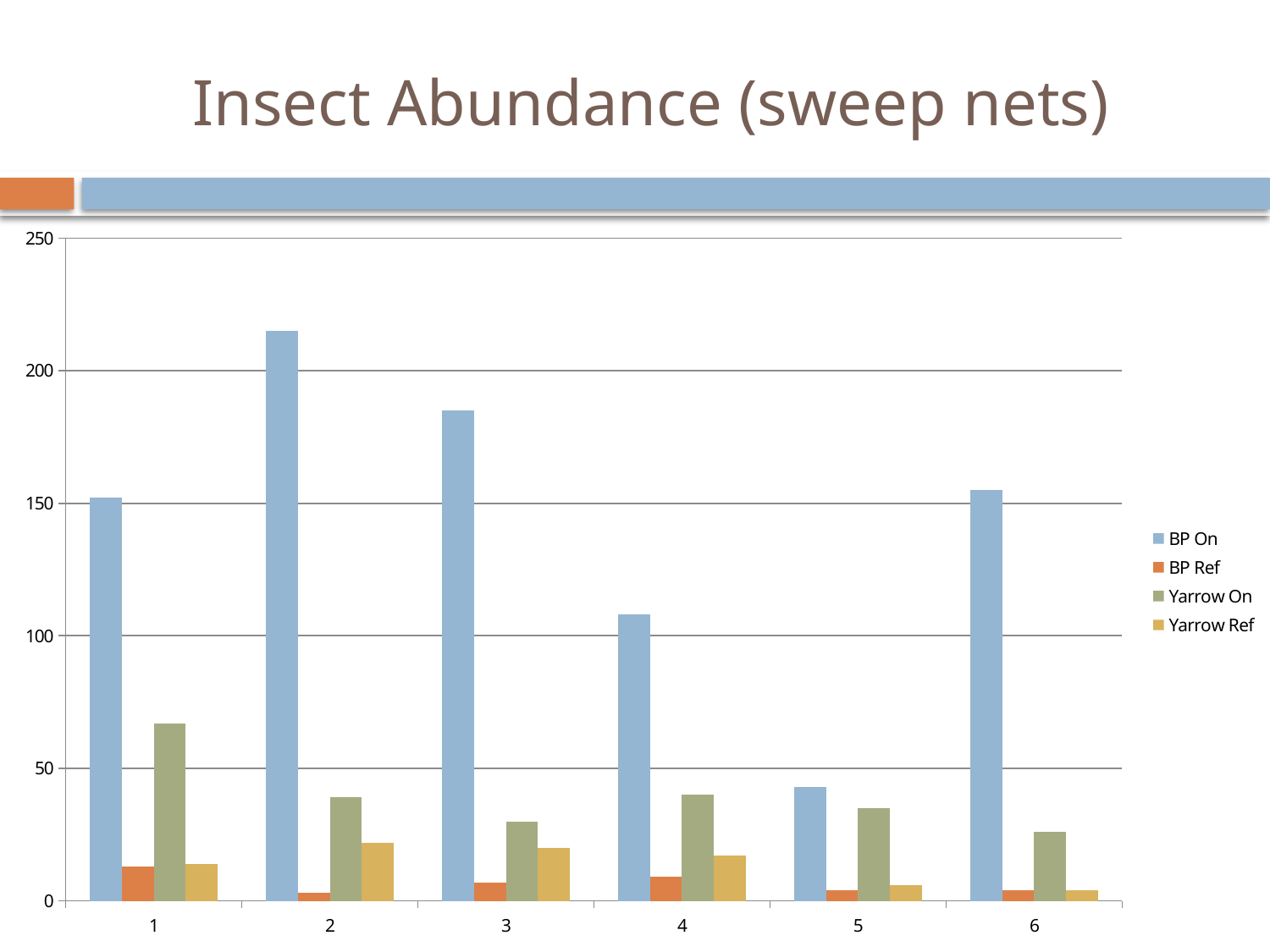
Is the BP On value for category 2 greater or less than 200? greater How many categories are shown along the x axis? 6 For which category is the BP On value highest? 2 Is the BP On value for category 5 greater or less than 50? less What is the title of the chart? Insect Abundance (sweep nets) For which category is the BP On value lowest? 5 Is the Yarrow On value for category 1 greater or less than 50? greater For which category is the Yarrow On value highest? 1 For category 1, which is larger: Yarrow On or Yarrow Ref? Yarrow On What kind of chart is shown on the slide? bar chart How many series does the legend list? 4